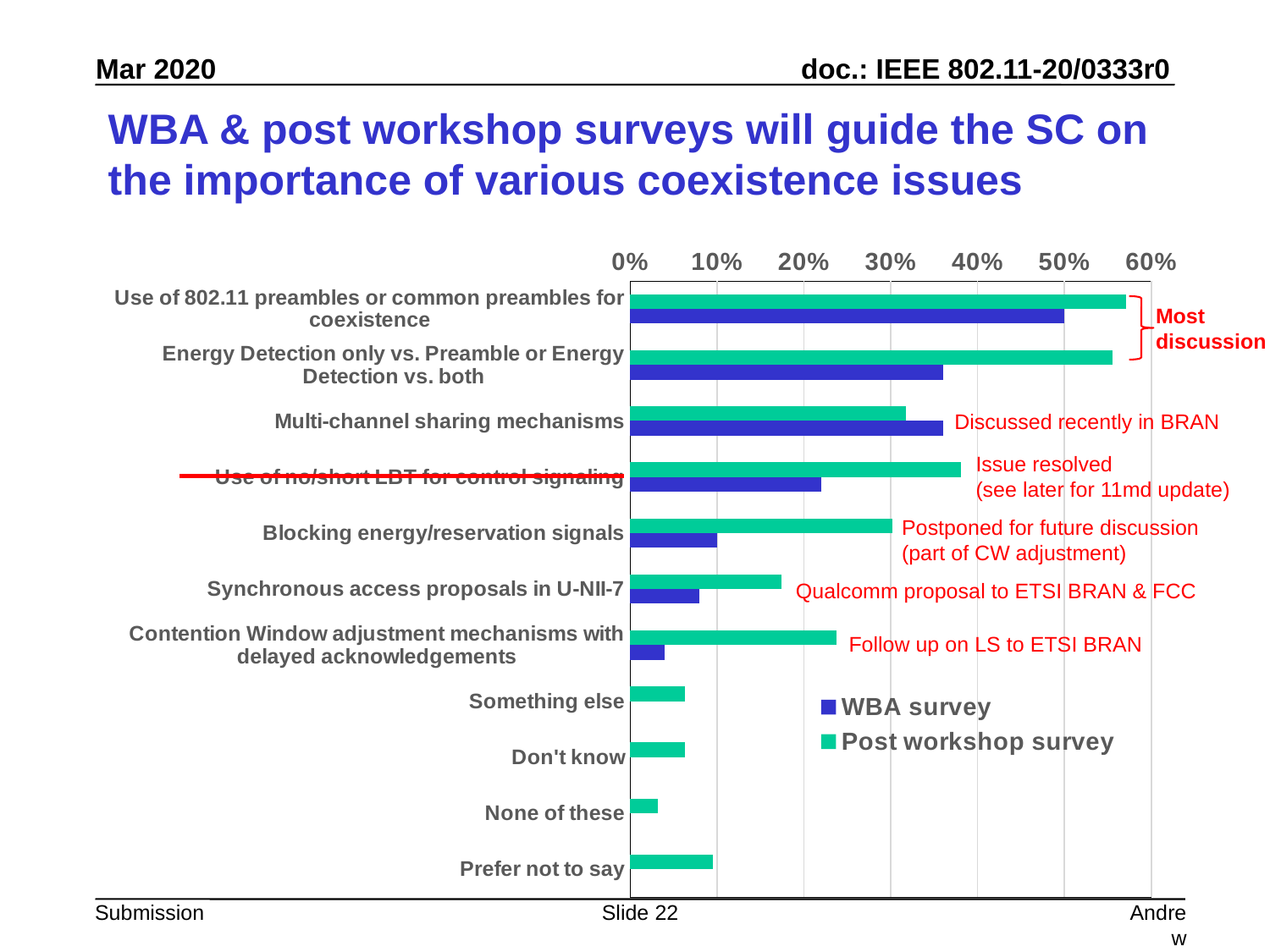
How many series does the chart legend list? 2 Is the WBA survey value for 'Contention Window adjustment mechanisms with delayed acknowledgements' greater or less than 10%? less Is the Post workshop survey value for 'Energy Detection only vs. Preamble or Energy Detection vs. both' greater or less than 50%? greater Which category has the highest value for the WBA survey? Use of 802.11 preambles or common preambles for coexistence How many categories are plotted on the chart? 11 For 'Blocking energy/reservation signals', which series has the larger value, WBA survey or Post workshop survey? Post workshop survey For 'Multi-channel sharing mechanisms', which series has the larger value, WBA survey or Post workshop survey? WBA survey Is the WBA survey value for 'Use of no/short LBT for control signaling' greater or less than 30%? less What kind of chart is shown on the slide? Bar chart What colour represents the WBA survey series in the chart? Blue Which category has the lowest value for the Post workshop survey? None of these